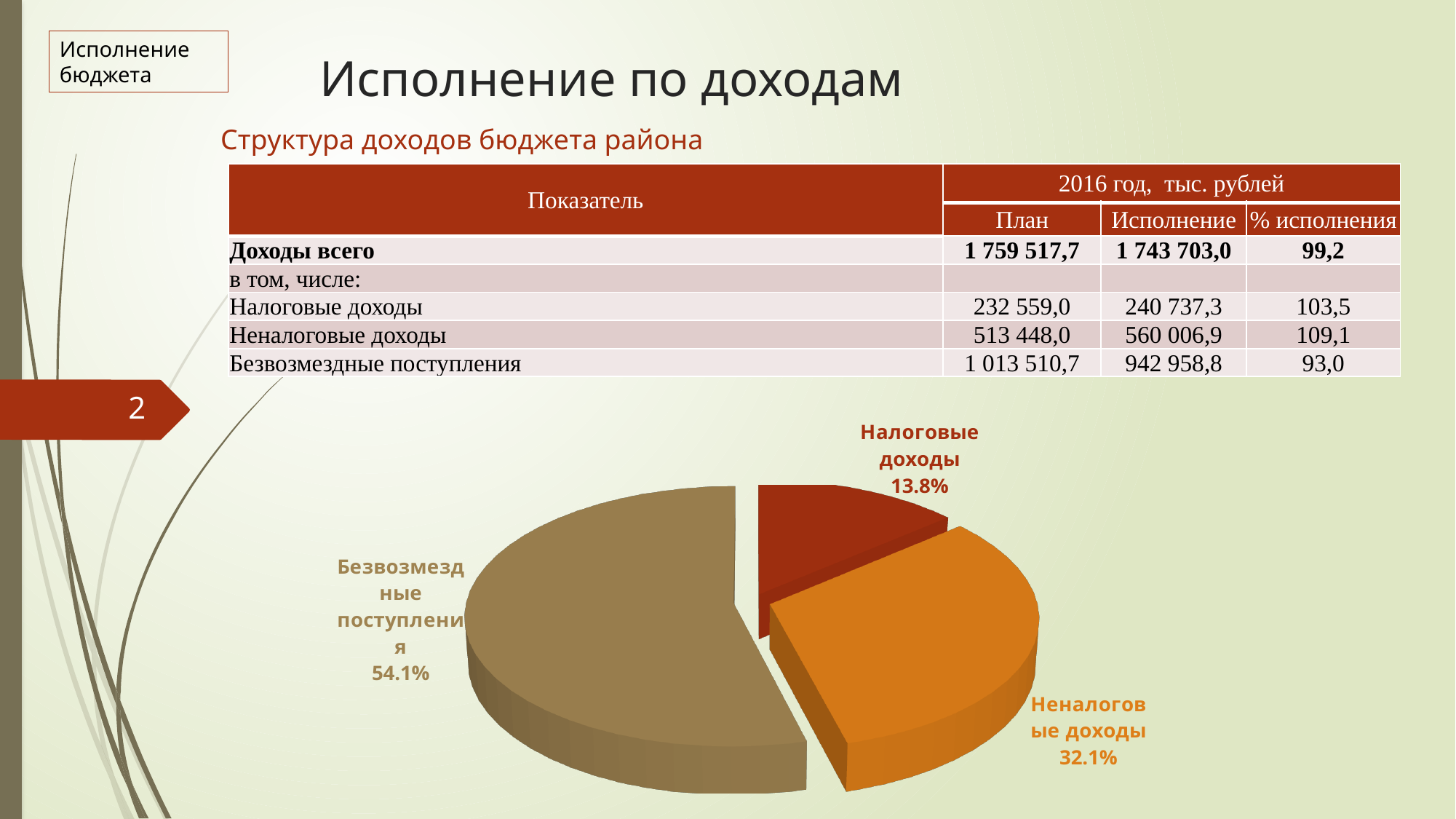
What share of the pie chart does Безвозмездные поступления have? 54.1% What colour is the Налоговые доходы slice in the pie chart? dark red Which slice of the pie chart is the smallest? Налоговые доходы What kind of chart is shown on the slide? pie chart What colour is the Неналоговые доходы slice in the pie chart? orange What is the difference in percentage points between the Безвозмездные поступления slice and the Неналоговые доходы slice? 22.0 How many slices does the pie chart have? 3 Which slice of the pie chart is the largest? Безвозмездные поступления Which is larger in the pie chart, Неналоговые доходы or Налоговые доходы? Неналоговые доходы What share of the pie chart does Налоговые доходы have? 13.8% What is the difference in percentage points between the Неналоговые доходы slice and the Налоговые доходы slice? 18.3 What share of the pie chart does Неналоговые доходы have? 32.1%